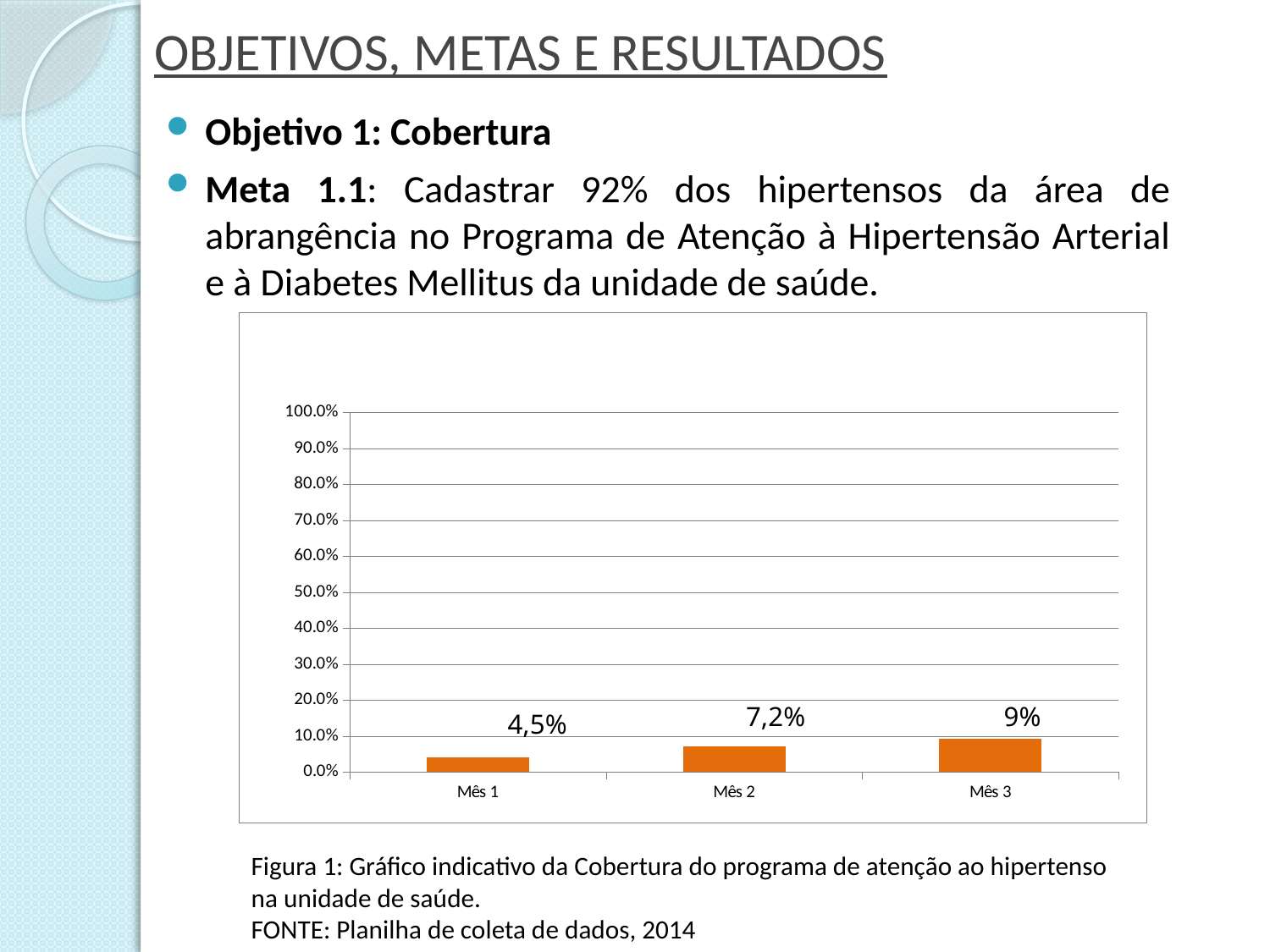
What is the value for Mês 2? 7,2% What is the difference between the values for Mês 3 and Mês 1? 4,5% Is the value for Mês 3 greater or less than 10.0%? less Which month has the lowest value? Mês 1 What is the difference between the values for Mês 2 and Mês 1? 2,7% What is the value for Mês 1? 4,5% How many months are shown on the x axis? 3 Which month has the highest value? Mês 3 What is the value for Mês 3? 9% What kind of chart is shown on the slide? bar chart Do the values rise or fall from Mês 1 to Mês 3? rise Which is larger, the value for Mês 2 or the value for Mês 3? Mês 3